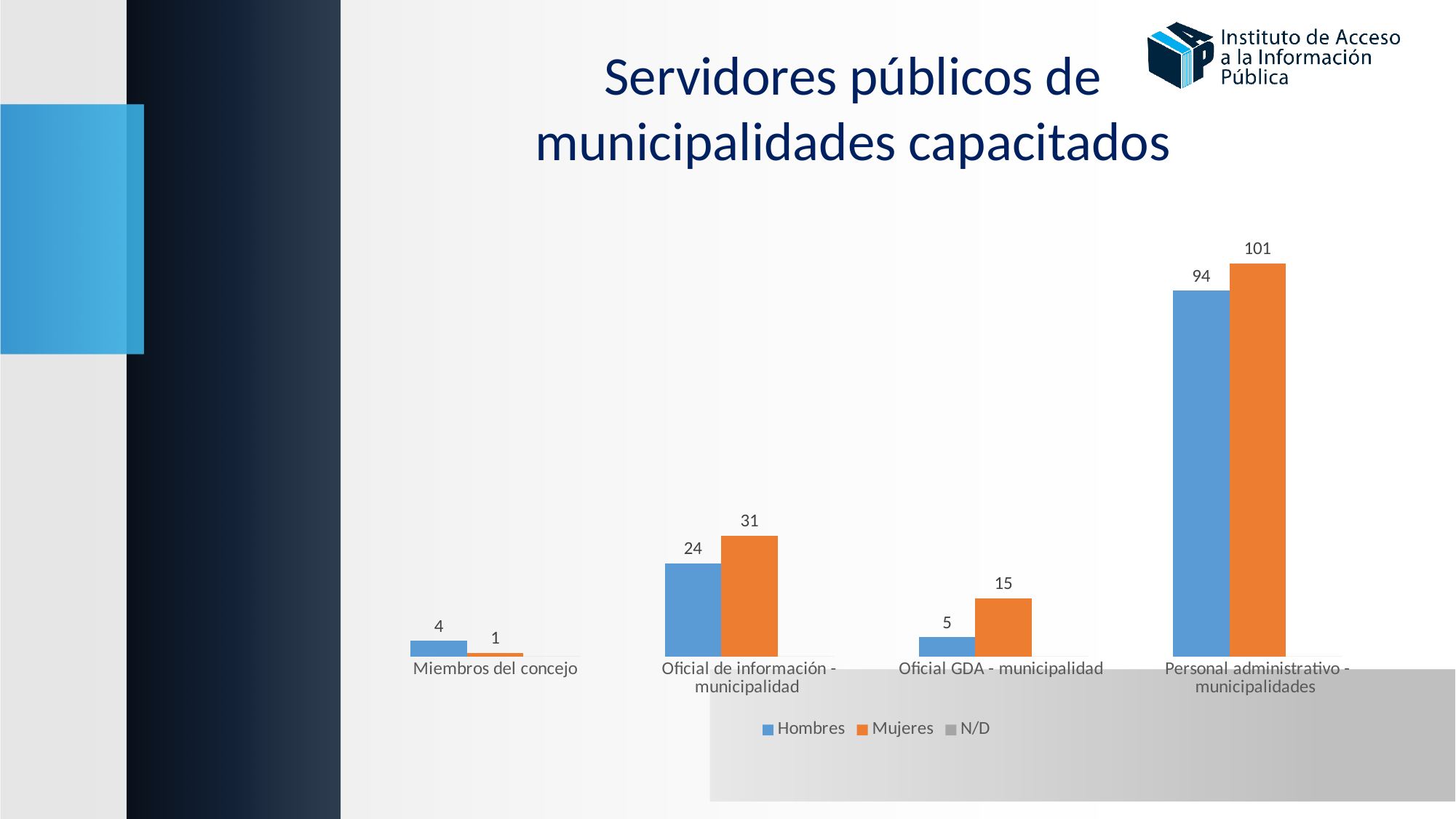
What kind of chart is shown on the slide? Bar chart What is the value for Hombres in the Oficial GDA - municipalidad category? 5 What is the difference between the Mujeres and Hombres values in the Personal administrativo - municipalidades category? 7 Which category has the highest value for Mujeres? Personal administrativo - municipalidades What colour represents the Mujeres series? Orange How many series does the legend list? 3 Which is larger in the Oficial GDA - municipalidad category, Hombres or Mujeres? Mujeres Which category has the lowest value for Hombres? Miembros del concejo What is the value for Hombres in the Personal administrativo - municipalidades category? 94 How many categories are shown on the x axis? 4 What is the value for Mujeres in the Miembros del concejo category? 1 What is the value for Mujeres in the Oficial de información - municipalidad category? 31